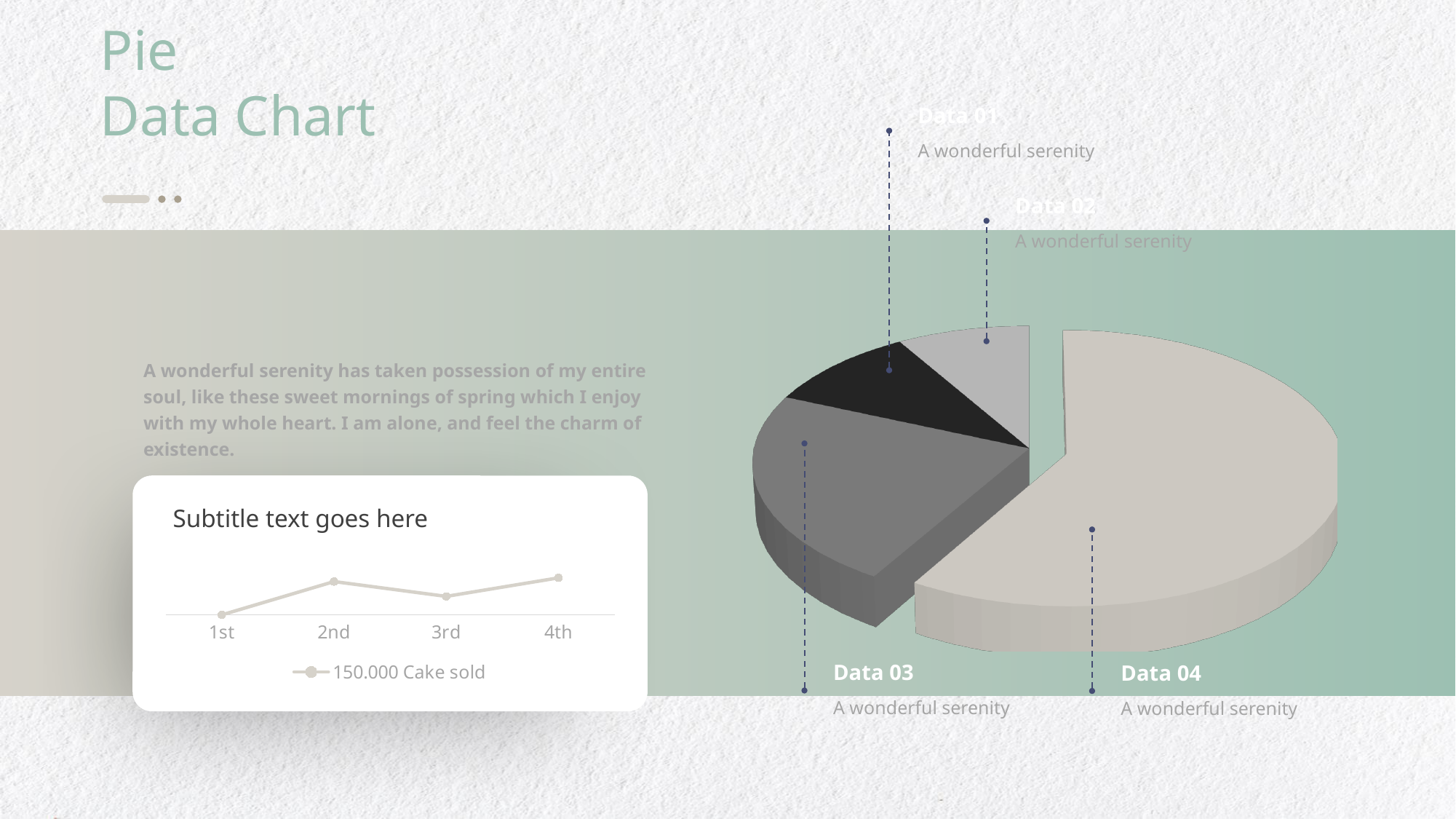
What is the legend entry of the small line chart on the left? 150.000 Cake sold In the pie chart on the right, which data label corresponds to the largest slice? Data 04 In the small line chart on the left, which category has the lowest value? 1st How many series does the legend of the small line chart on the left list? 1 In the small line chart on the left, which value is higher, 1st or 2nd? 2nd What kind of chart is the large chart on the right side of the slide? pie chart What kind of chart is the small chart in the white box on the left? line chart In the small line chart on the left, does the value rise or fall from 2nd to 3rd? fall How many slices does the pie chart on the right have? 4 In the pie chart on the right, which slice is larger, Data 04 or Data 03? Data 04 In the pie chart on the right, which slice is larger, Data 03 or Data 01? Data 03 How many data points are plotted in the small line chart on the left? 4